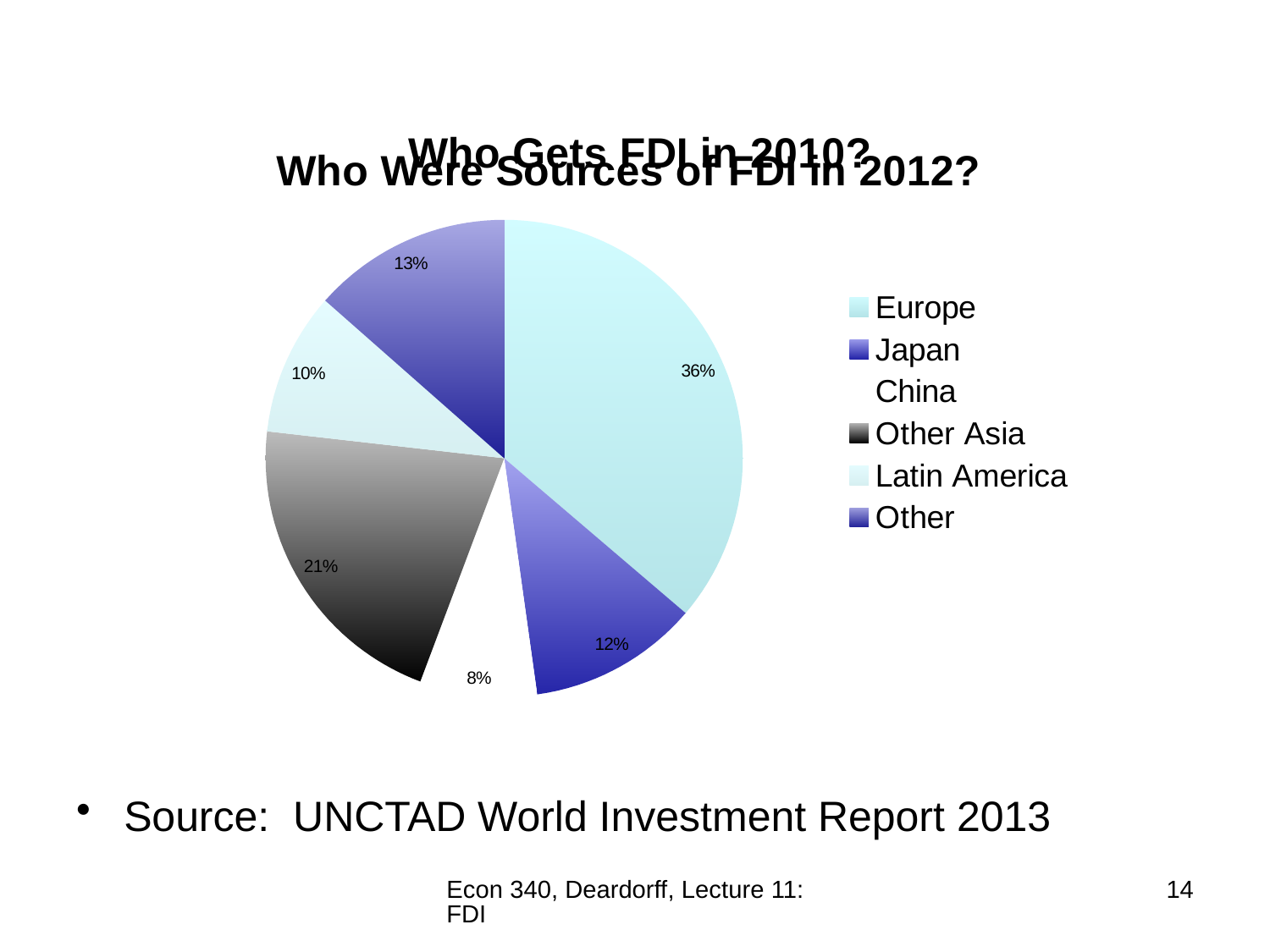
What percentage is shown for Other Asia? 21% What type of chart is shown on the slide? Pie chart How many percentage points larger is Europe's share than Other Asia's share? 15 What share of the pie does Europe account for? 36% What percentage is shown for Latin America? 10% What percentage is shown for the Other category? 13% What share does China have in the pie chart? 8% How many categories does the legend list? 6 Which is larger, the share for Japan or the share for Latin America? Japan What percentage is shown for Japan? 12% Which category has the smallest slice of the pie? China Which category has the largest slice of the pie? Europe